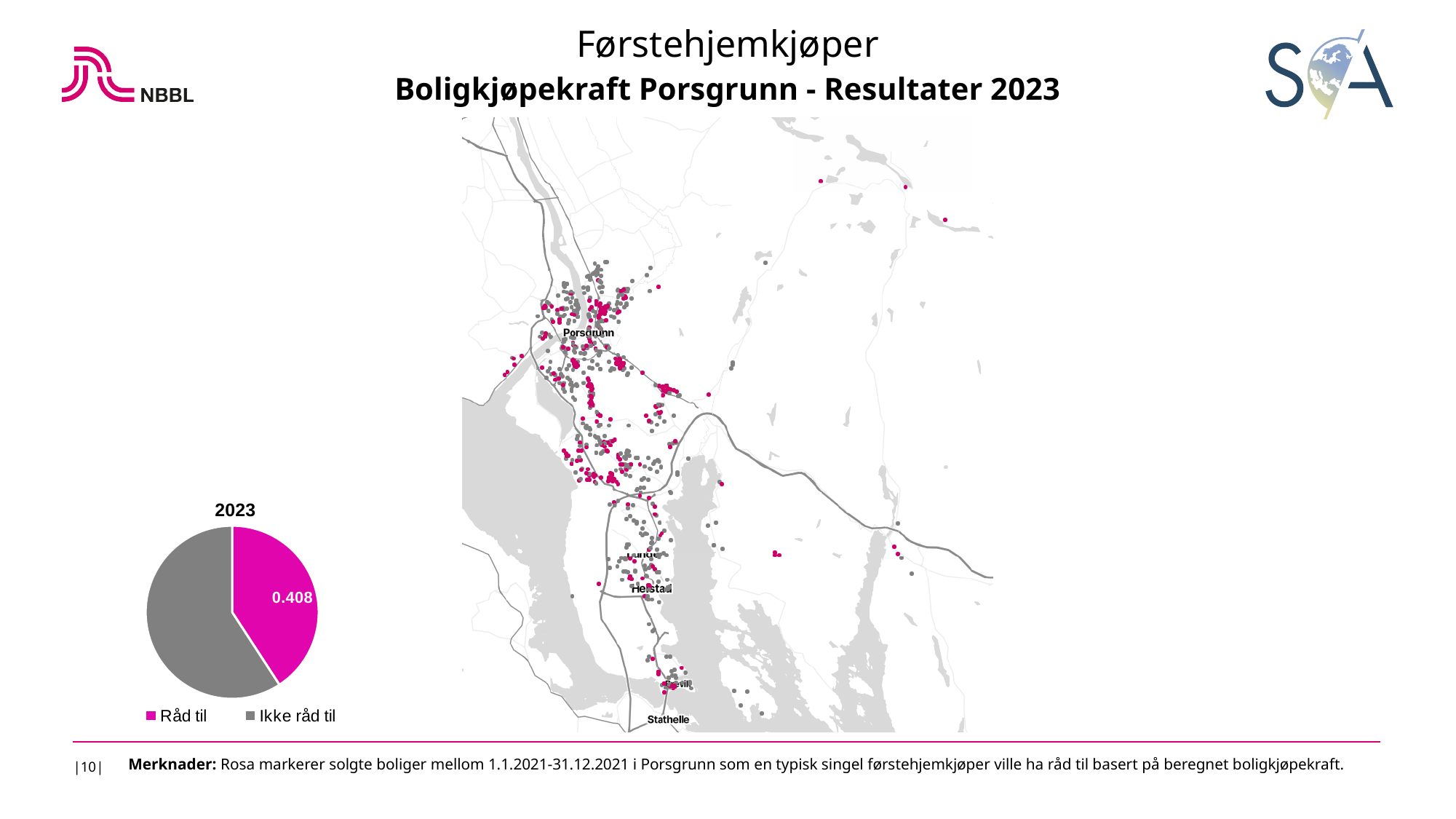
What kind of chart is shown at the bottom left of the slide? pie chart What colour is the Råd til slice in the pie chart? pink How many entries does the legend of the pie chart list? 2 In the pie chart, which is larger: Råd til or Ikke råd til? Ikke råd til In the pie chart, what is the value shown for Råd til? 0.408 How many slices does the pie chart have? 2 What is the title of the pie chart? 2023 Which slice of the pie chart is the smallest? Råd til What share of the pie chart does the Råd til slice represent? 0.408 Which slice of the pie chart is the largest? Ikke råd til